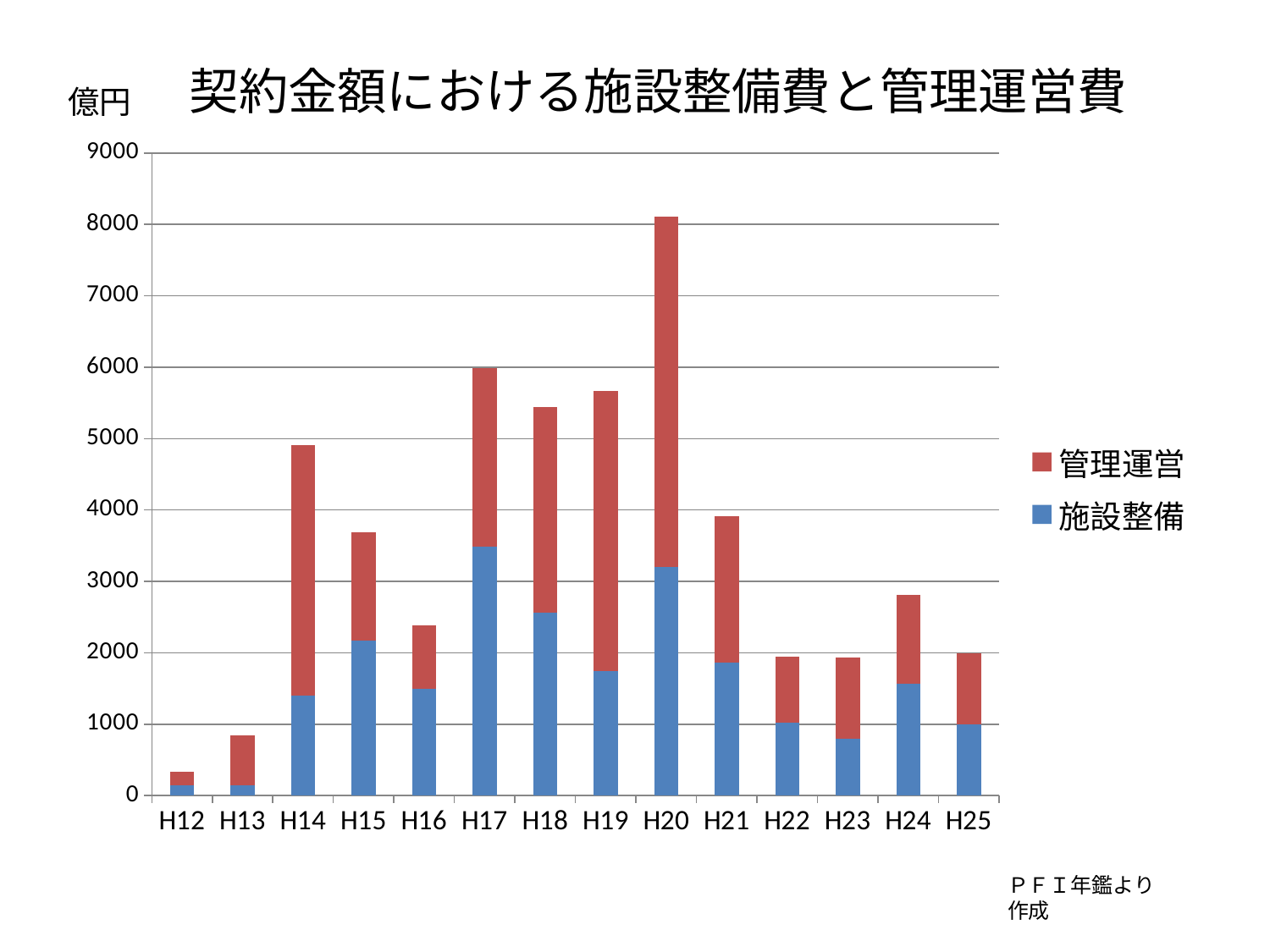
Which year has the highest total contract amount? H20 Is the total value for H20 greater or less than 7000? greater Is the 施設整備 value for H23 greater or less than 1000? less How many series does the legend list? 2 Which year has the lowest total contract amount? H12 Which colour represents the 管理運営 series? red How many years (categories) are shown on the x axis? 14 Is the total value for H13 greater or less than 1000? less Which year has a larger total contract amount, H14 or H15? H14 What kind of chart is shown on the slide? stacked bar chart Do the total values rise or fall from H20 to H23? fall